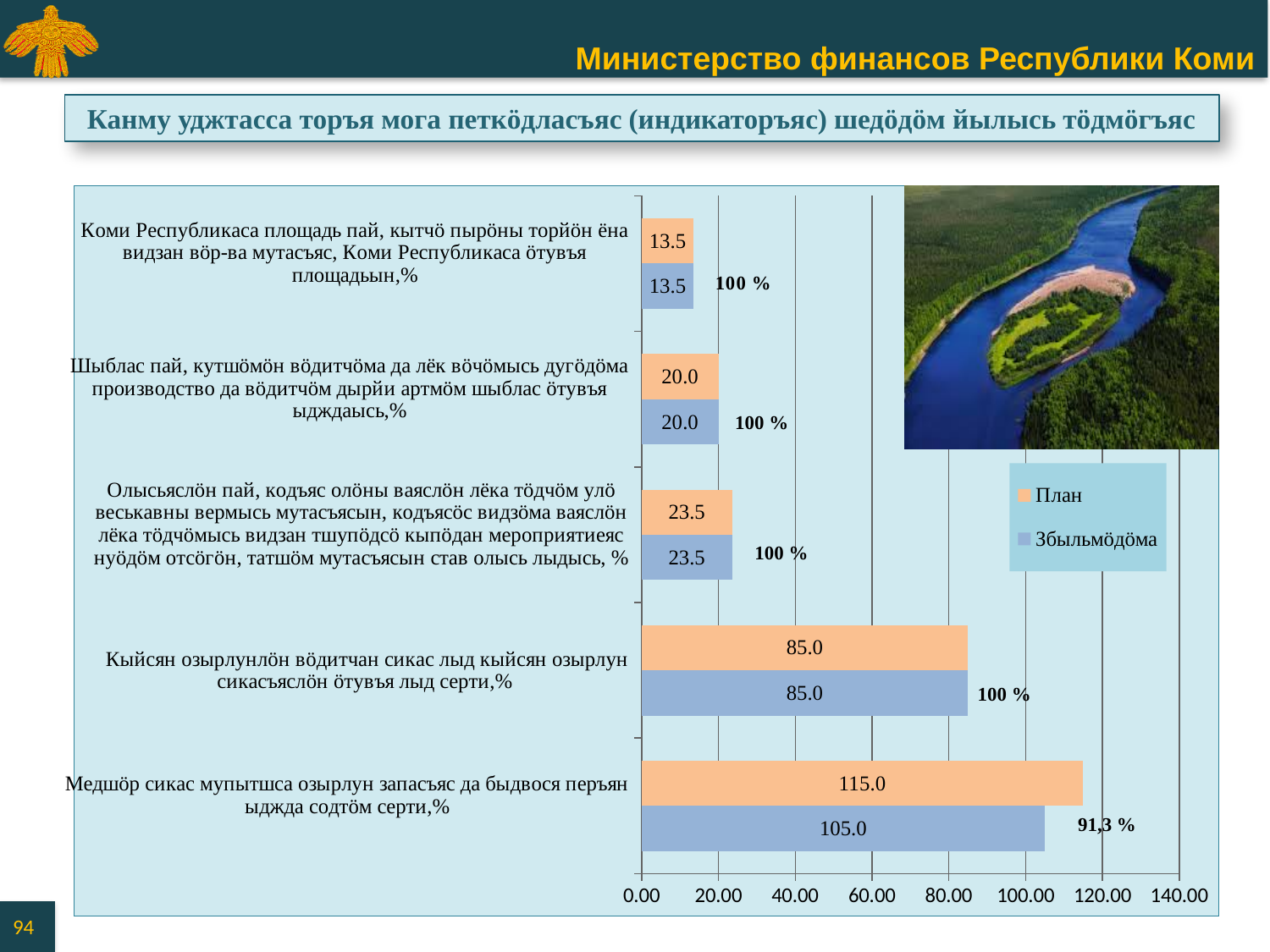
What is the План value for the category 'Кыйсян озырлунлӧн вӧдитчан сикас лыд кыйсян озырлун сикасъяслӧн ӧтувъя лыд серти,%'? 85.0 How many categories are plotted in the chart? 5 Which category has the lowest Збыльмӧдӧма value? Коми Республикаса площадь пай, кытчӧ пырӧны торйӧн ёна видзан вӧр-ва мутасъяс, Коми Республикаса ӧтувъя площадьын,% What type of chart is shown on the slide? bar chart What is the План value for the bottom category (Медшӧр сикас мупытшса озырлун запасъяс да быдвося перъян ыджда содтӧм серти,%)? 115.0 What is the Збыльмӧдӧма value for the top category (Коми Республикаса площадь пай...)? 13.5 Which is larger for the bottom category (Медшӧр сикас мупытшса озырлун запасъяс...): the План value or the Збыльмӧдӧма value? План What is the difference between the План and Збыльмӧдӧма values for the bottom category (Медшӧр сикас мупытшса озырлун запасъяс...)? 10.0 How many series does the chart legend list? 2 Which category has the highest План value? Медшӧр сикас мупытшса озырлун запасъяс да быдвося перъян ыджда содтӧм серти,% What percentage label is shown next to the bars for the bottom category (Медшӧр сикас мупытшса озырлун запасъяс...)? 91,3 % What is the Збыльмӧдӧма value for the bottom category (Медшӧр сикас мупытшса озырлун запасъяс да быдвося перъян ыджда содтӧм серти,%)? 105.0